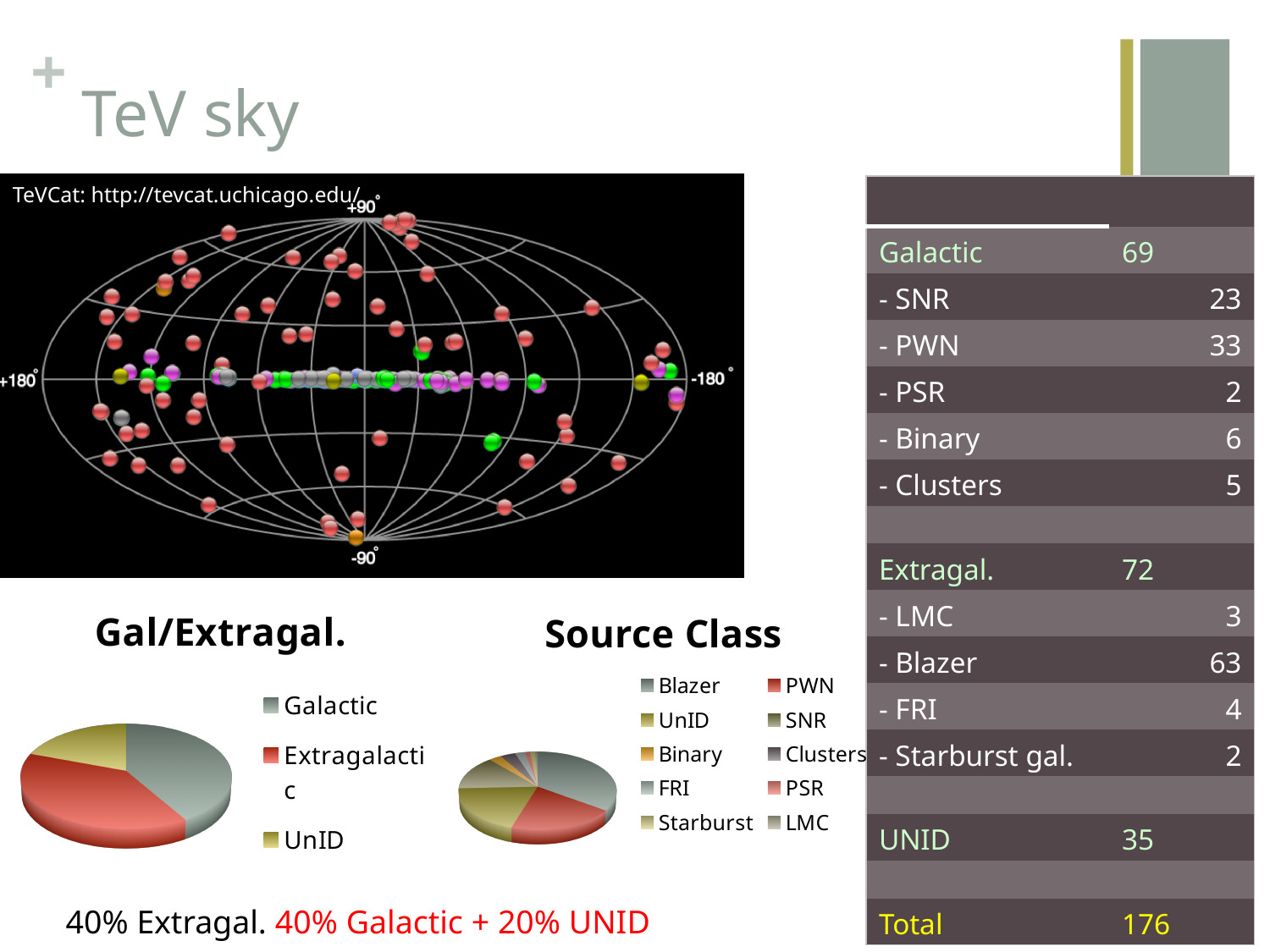
In the "Source Class" chart, which slice is larger, Blazer or PWN? Blazer In the "Gal/Extragal." chart, which category has the smallest slice? UnID What is the title of the pie chart on the left? Gal/Extragal. In the "Source Class" chart, which slice is larger, PWN or FRI? PWN How many pie charts are shown on the slide? 2 How many categories does the legend of the "Gal/Extragal." chart list? 3 In the "Gal/Extragal." chart, which slice is larger, Galactic or UnID? Galactic What kind of chart is the "Source Class" chart? pie chart What is the title of the pie chart on the right? Source Class What kind of chart is the "Gal/Extragal." chart? pie chart In the "Source Class" chart, which category has the largest slice? Blazer How many categories does the legend of the "Source Class" chart list? 10